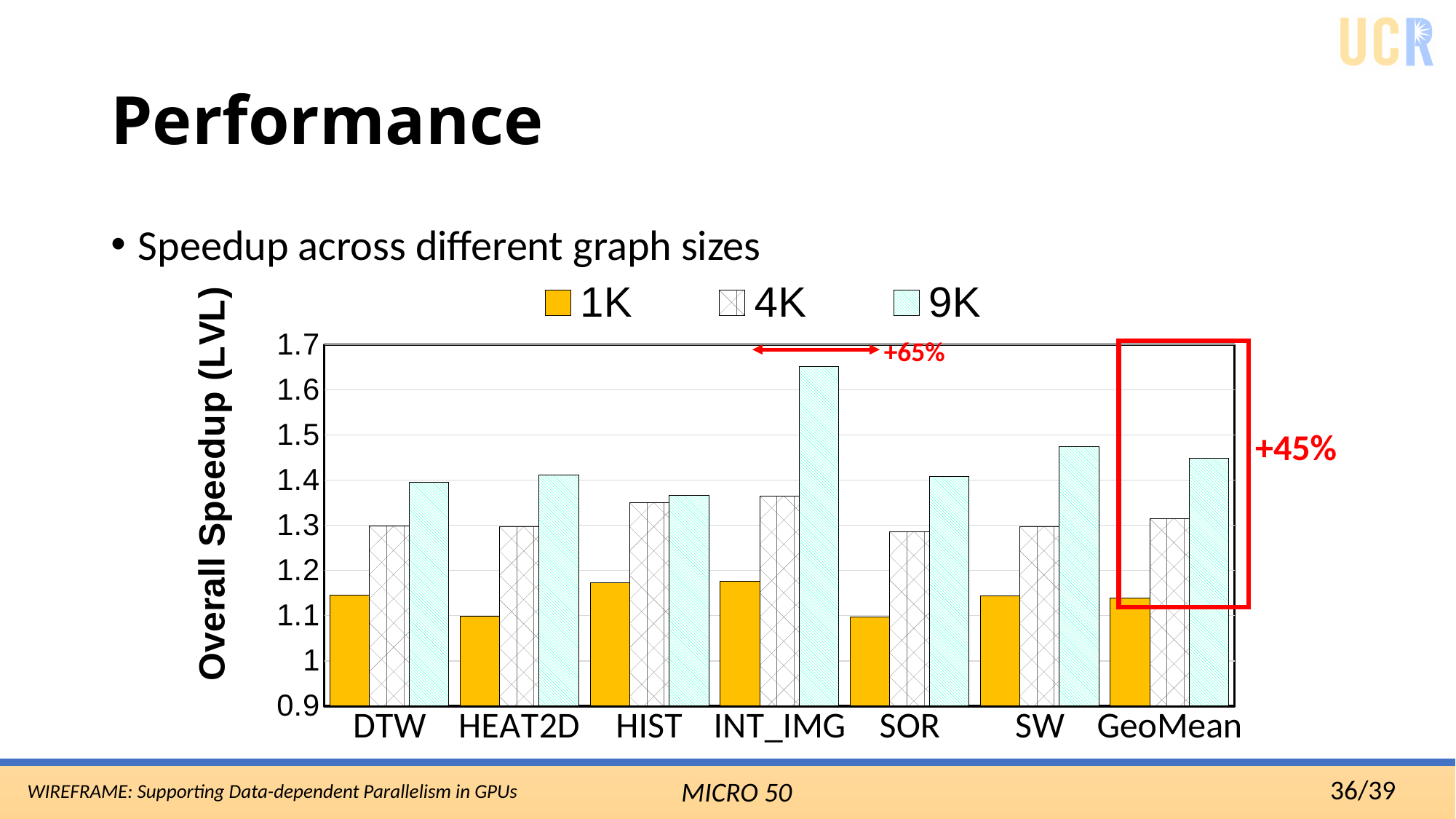
How many series does the legend list? 3 Is the 4K value for GeoMean greater or less than 1.4? less Is the 9K value for SW greater or less than 1.4? greater For INT_IMG, which series has the larger value, 4K or 9K? 9K Is the 1K value for HEAT2D greater or less than 1.2? less Which category has the highest 9K speedup? INT_IMG What is the label of the y axis? Overall Speedup (LVL) Which is larger, the 9K value for SW or the 9K value for HIST? SW How many categories are shown on the x axis? 7 What kind of chart is shown on the slide? bar chart What percentage annotation is shown next to the red box around GeoMean? +45%